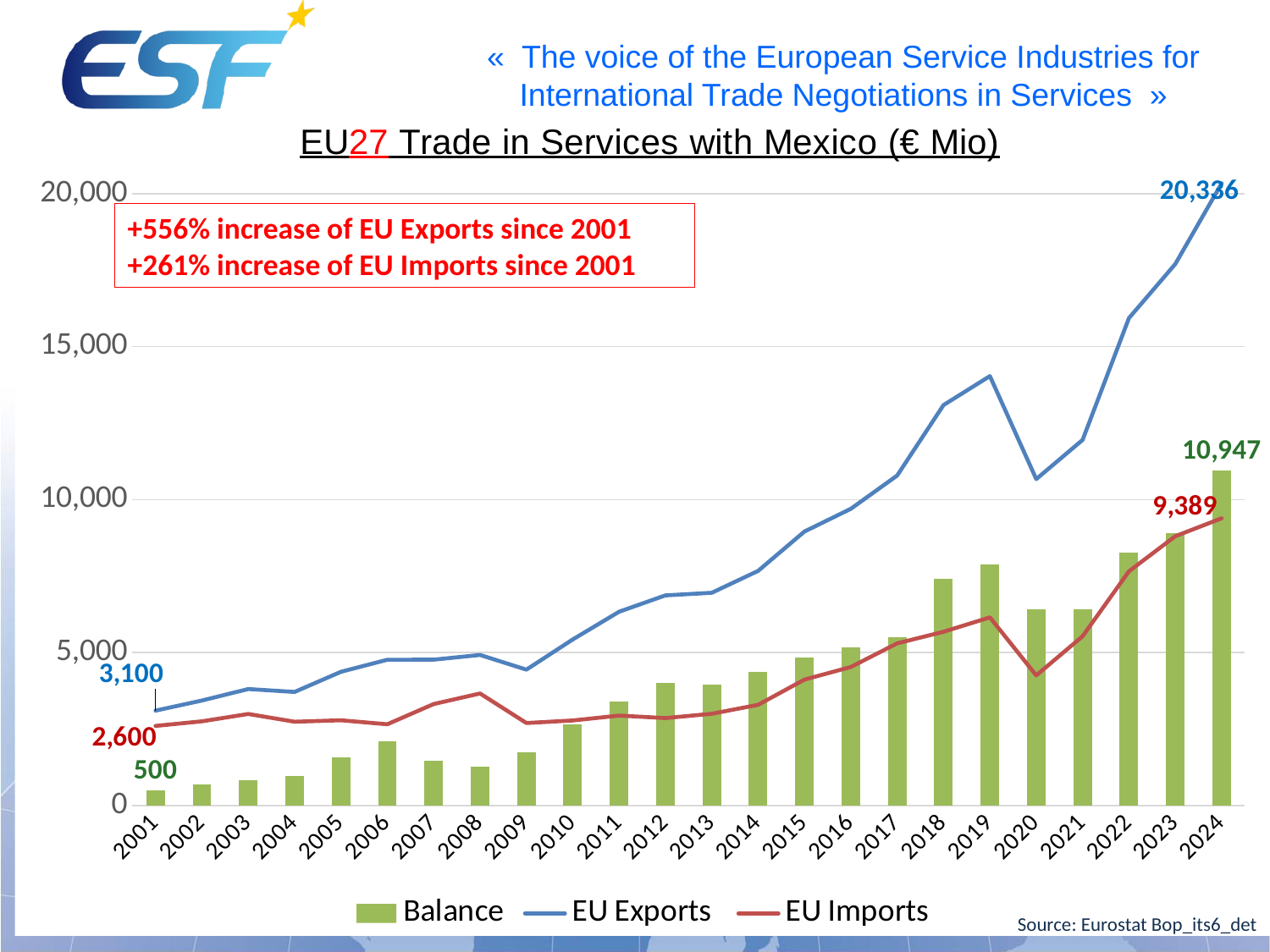
How many series does the legend list? 3 What is the difference between EU Exports and EU Imports in 2001? 500 What is the Balance value shown for 2001? 500 Is the value of EU Exports in 2019 greater or less than 10,000? greater What is the value of EU Exports in 2001? 3,100 What is the value of EU Imports in 2024? 9,389 What is the Balance value shown for 2024? 10,947 How many years are shown on the x axis? 24 What is the title of the chart? EU27 Trade in Services with Mexico (€ Mio) In 2024, which is larger, EU Exports or EU Imports? EU Exports Is the Balance value for 2010 greater or less than 5,000? less What is the value of EU Exports in 2024? 20,336